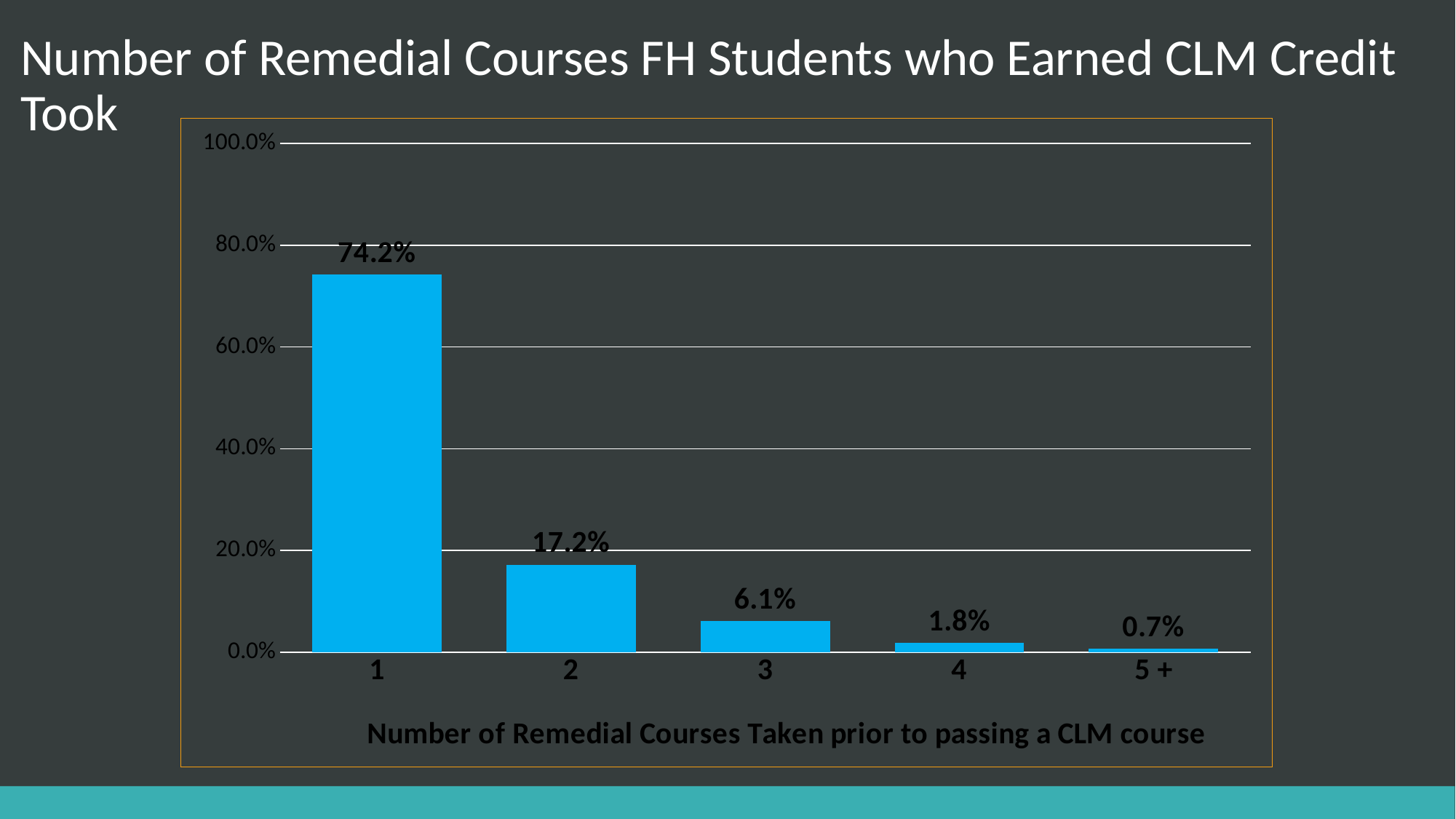
What is the x-axis title of the chart? Number of Remedial Courses Taken prior to passing a CLM course What percentage of students took 1 remedial course prior to passing a CLM course? 74.2% Which is larger, the value for 3 remedial courses or the value for 4 remedial courses? 3 What is the value shown for the category '3' remedial courses? 6.1% How many categories are shown on the x axis? 5 Which category has the highest percentage? 1 Is the value for 2 remedial courses greater or less than 20.0%? less What is the difference between the values for 1 remedial course and 2 remedial courses? 57.0% Do the values rise or fall as the number of remedial courses increases along the x axis? fall Which category has the lowest percentage? 5 + What kind of chart is shown on the slide? bar chart What percentage is shown for the '5 +' category? 0.7%